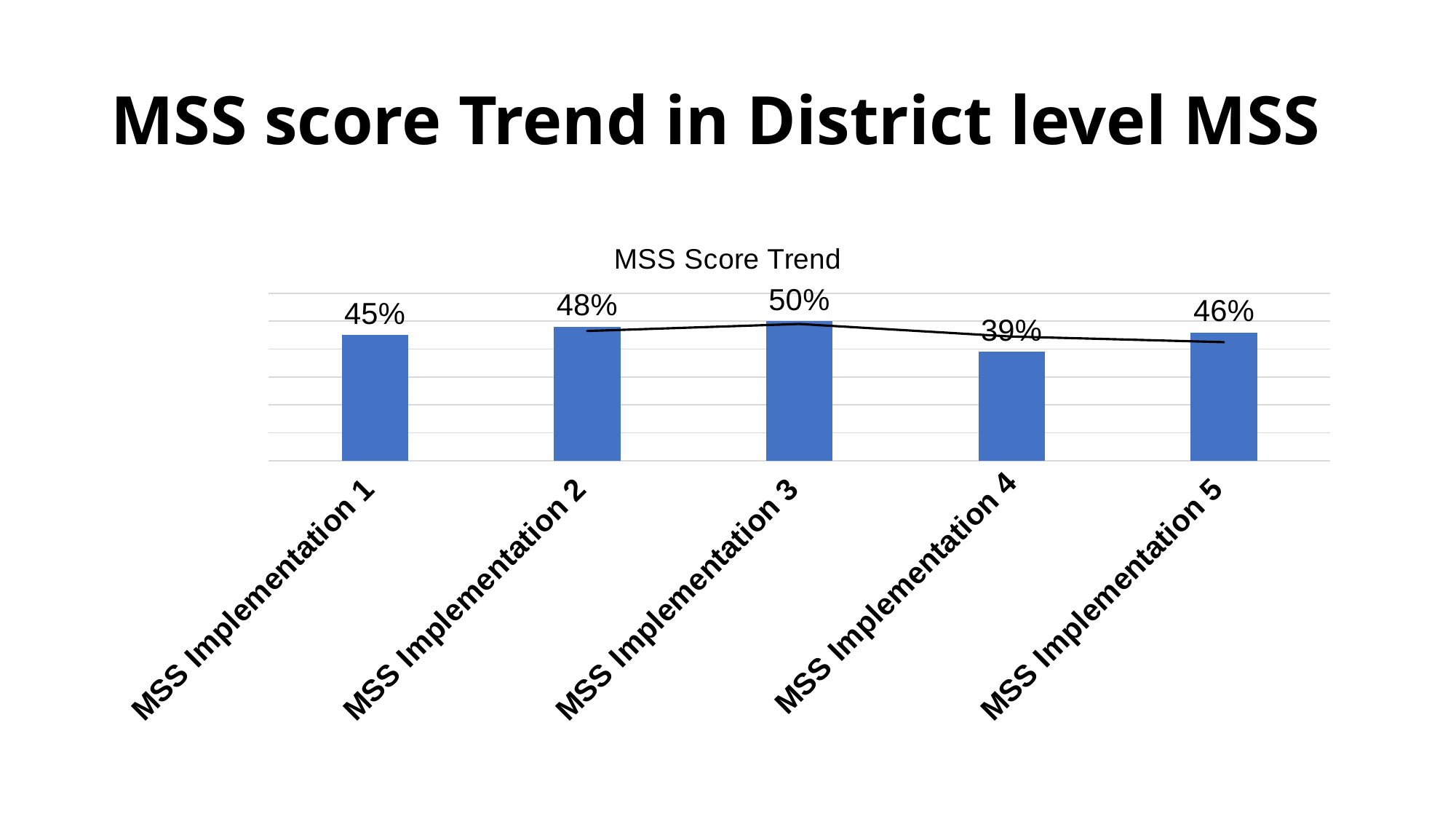
What is the MSS score for MSS Implementation 4? 39% What is the MSS score for MSS Implementation 3? 50% Which implementation has the highest MSS score? MSS Implementation 3 What is the title of the chart? MSS Score Trend What is the MSS score for MSS Implementation 1? 45% What kind of chart is used to show the MSS scores? Bar chart What is the difference between the MSS scores of MSS Implementation 3 and MSS Implementation 4? 11% Which implementation has the lowest MSS score? MSS Implementation 4 Does the MSS score rise or fall from MSS Implementation 3 to MSS Implementation 4? Fall Which has a higher MSS score, MSS Implementation 2 or MSS Implementation 5? MSS Implementation 2 How many implementations are shown on the chart? 5 What is the MSS score for MSS Implementation 5? 46%